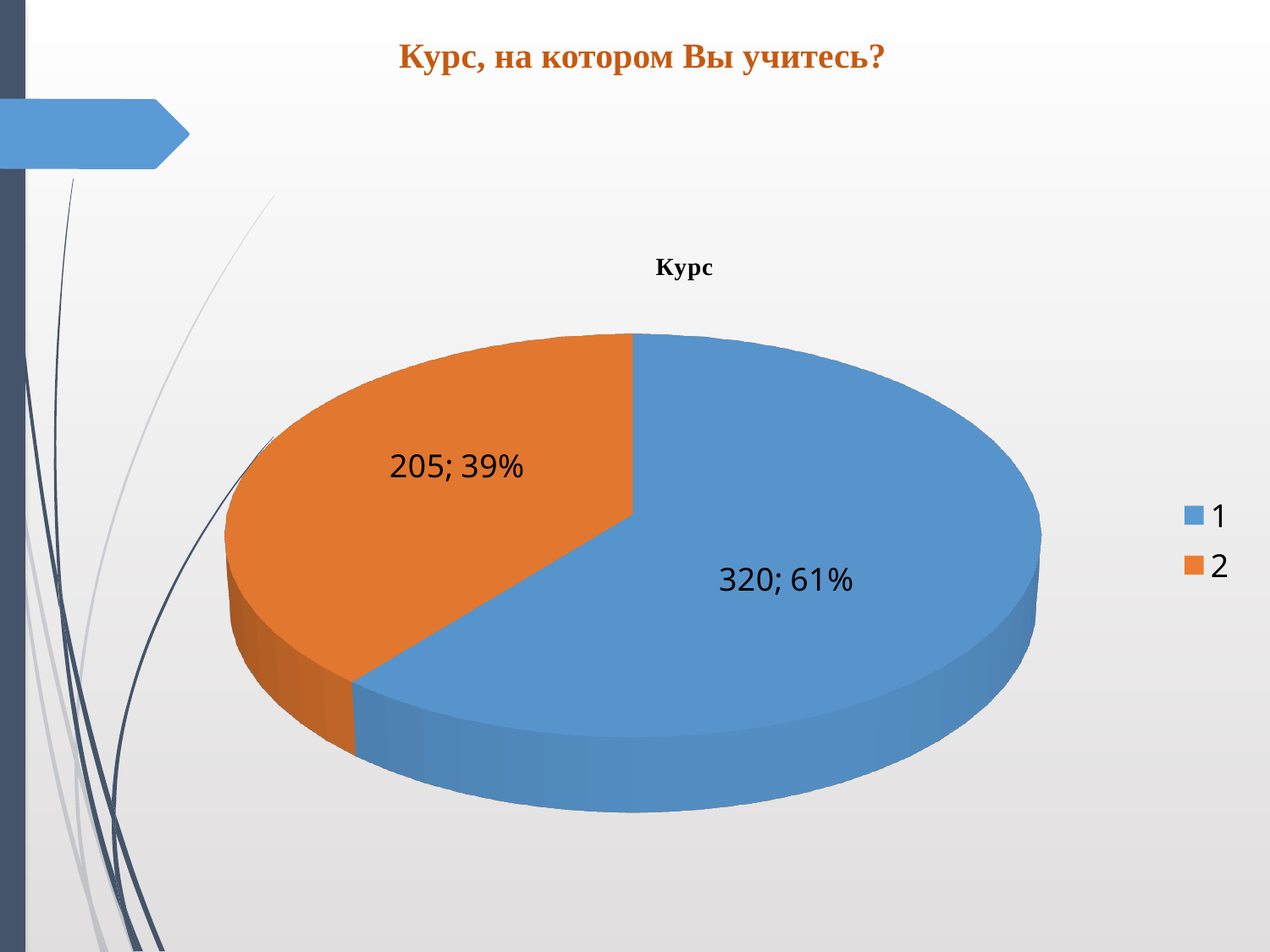
What is the value for category 1? 320 What is the title of the chart? Курс How many entries does the legend list? 2 What share of the pie does category 1 represent? 61% Which category has the smallest slice? 2 Which colour represents category 2 in the legend? orange What is the difference between the values for category 1 and category 2? 115 Which category has the largest slice? 1 What share of the pie does category 2 represent? 39% What type of chart is shown on the slide? pie chart How many slices does the pie chart have? 2 What is the value for category 2? 205